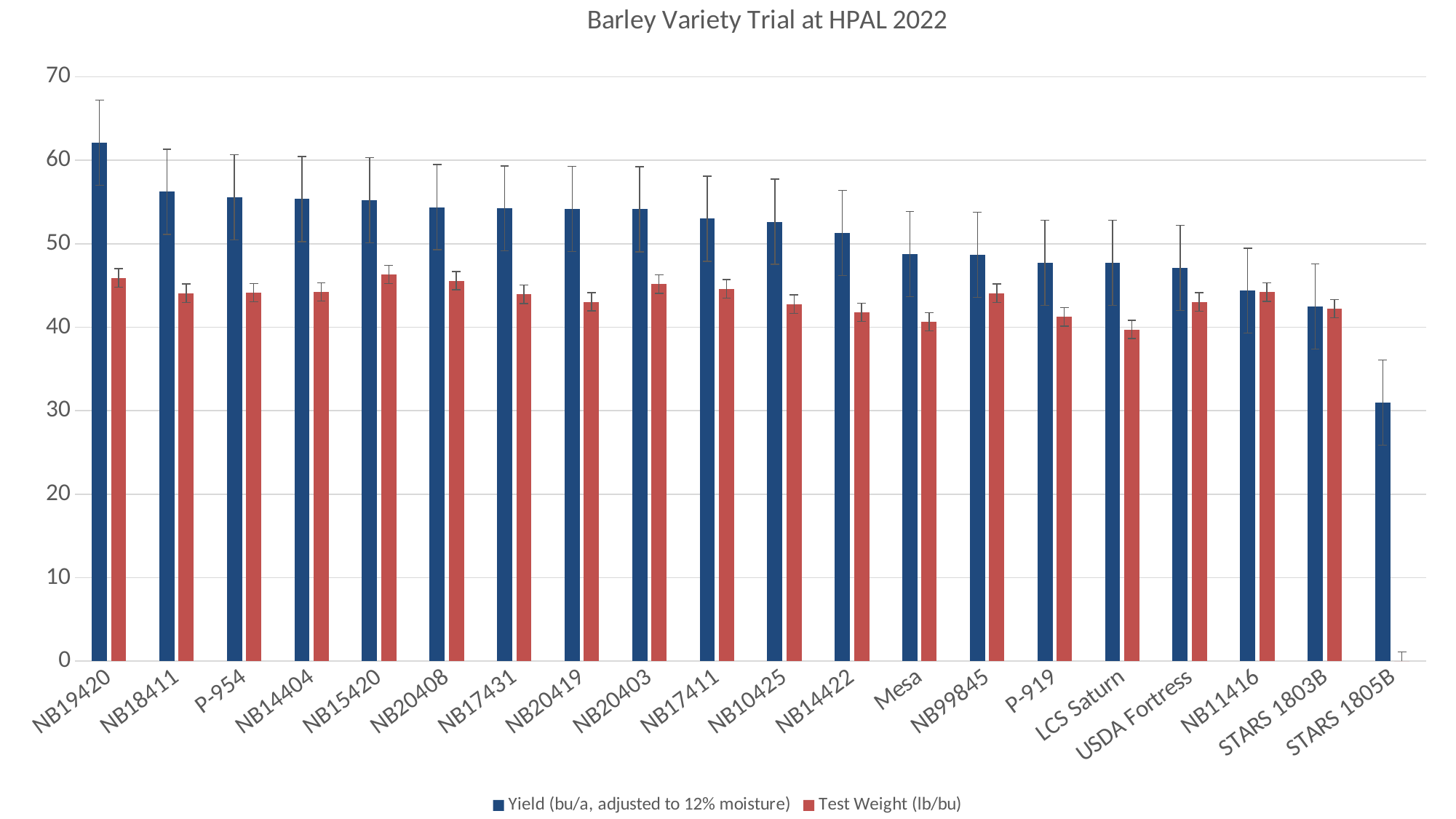
How many series does the legend list? 2 Which variety has the highest yield? NB19420 Which variety has the lowest yield? STARS 1805B Is the yield for STARS 1805B greater or less than 40? less Is the test weight for NB19420 greater or less than 40? greater Which has the larger yield, NB11416 or STARS 1805B? NB11416 Which has the larger yield, NB19420 or NB18411? NB19420 Do the yield values generally rise or fall from left to right along the x axis? fall Is the yield for Mesa greater or less than 50? less How many barley varieties are shown on the x axis? 20 What kind of chart is shown on the slide? Bar chart